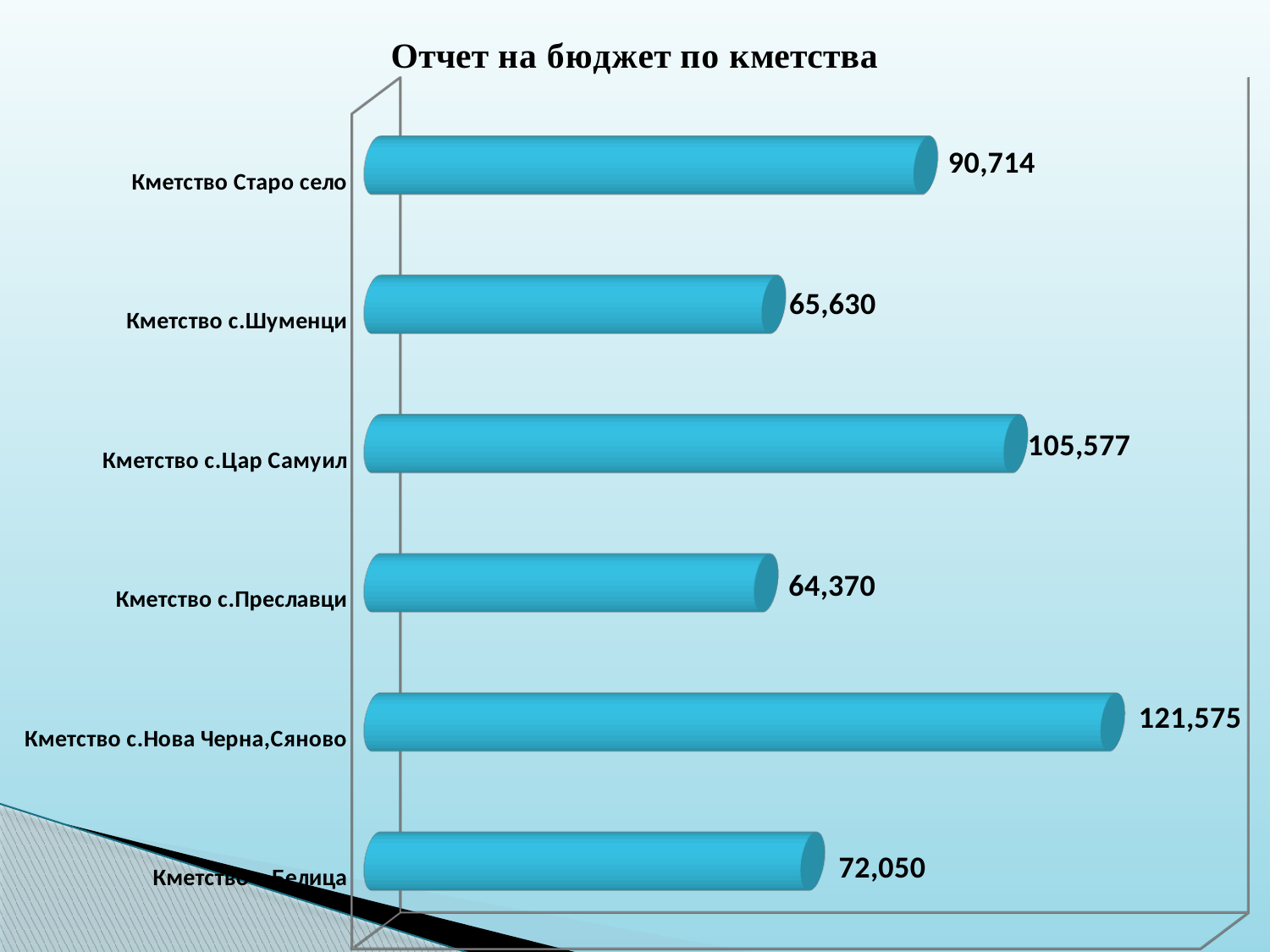
What is the difference between the values for Кметство Старо село and Кметство с.Шуменци? 25,084 Which category has the lowest value? Кметство с.Преславци Which category has the highest value? Кметство с.Нова Черна,Сяново Which is larger, the value for Кметство Старо село or the value for Кметство с.Шуменци? Кметство Старо село How many categories are shown in the chart? 6 What is the value for Кметство Старо село? 90,714 What is the value for Кметство с.Преславци? 64,370 What is the title of the chart? Отчет на бюджет по кметства What is the value for Кметство с.Шуменци? 65,630 What is the difference between the values for Кметство с.Нова Черна,Сяново and Кметство с.Цар Самуил? 15,998 What kind of chart is shown on the slide? Bar chart What is the value for Кметство с.Цар Самуил? 105,577